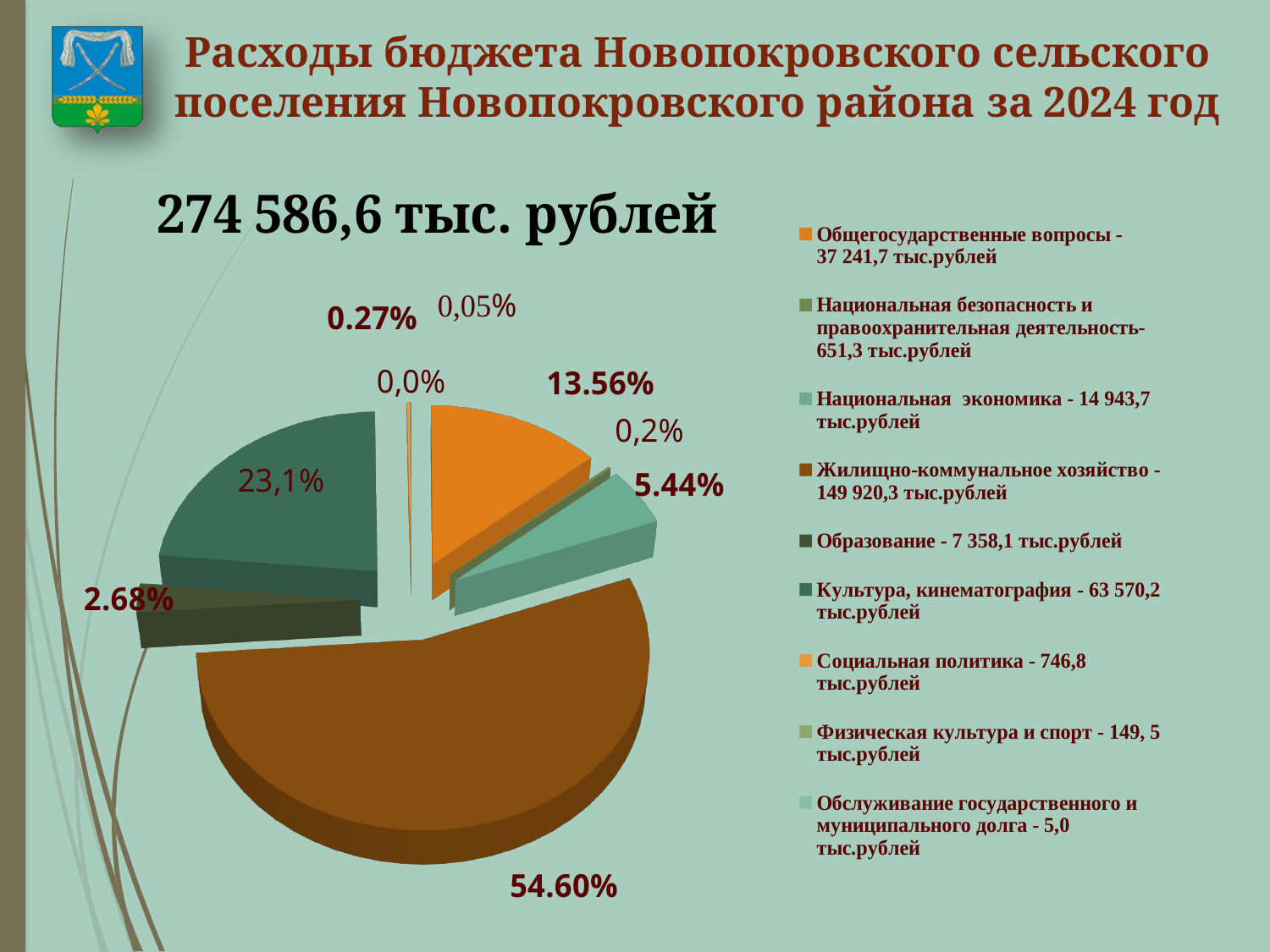
What amount does the legend give for Культура, кинематография? 63 570,2 тыс.рублей Which is larger: the amount for Общегосударственные вопросы or the amount for Национальная экономика? Общегосударственные вопросы What percentage share is shown for Образование? 2.68% What percentage share is shown for Культура, кинематография? 23,1% What amount does the legend give for Жилищно-коммунальное хозяйство? 149 920,3 тыс.рублей What percentage share is shown for Общегосударственные вопросы? 13.56% How many categories does the legend of the pie chart list? 9 What kind of chart is shown on the slide? pie chart Which category has the largest slice of the pie chart? Жилищно-коммунальное хозяйство What total amount of budget expenditure is shown above the pie chart? 274 586,6 тыс. рублей